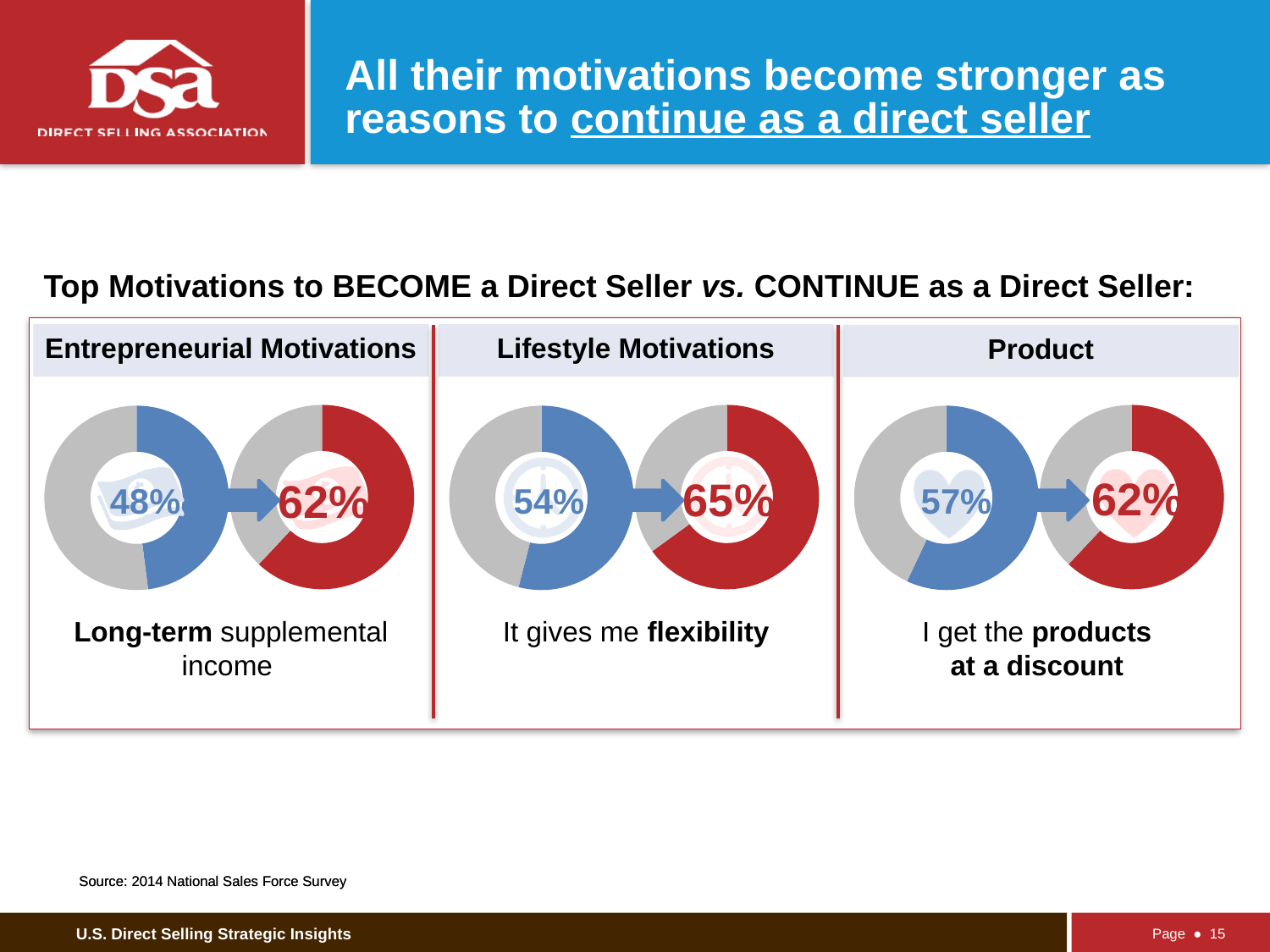
In the Product panel, what percentage is shown in the blue donut chart for 'I get the products at a discount'? 57% In the Product panel, what percentage is shown in the red donut chart for 'I get the products at a discount'? 62% In the Lifestyle Motivations panel, what percentage is shown in the blue donut chart for 'It gives me flexibility'? 54% What type of chart is used to display the percentages on this slide? Donut (pie) chart In the Entrepreneurial Motivations panel, what is the difference between the red donut value (62%) and the blue donut value (48%)? 14% In the Entrepreneurial Motivations panel, what percentage is shown in the red donut chart for 'Long-term supplemental income' as a reason to continue as a direct seller? 62% Which panel's blue donut chart shows the lowest percentage for becoming a direct seller? Entrepreneurial Motivations In the Lifestyle Motivations panel, what is the difference between the red donut value and the blue donut value? 11% Which panel's red donut chart shows the highest percentage for continuing as a direct seller? Lifestyle Motivations In the Lifestyle Motivations panel, what percentage is shown in the red donut chart for 'It gives me flexibility'? 65% How many donut charts are shown on the slide in total? 6 In the Entrepreneurial Motivations panel, what percentage is shown in the blue donut chart for 'Long-term supplemental income' as a reason to become a direct seller? 48%